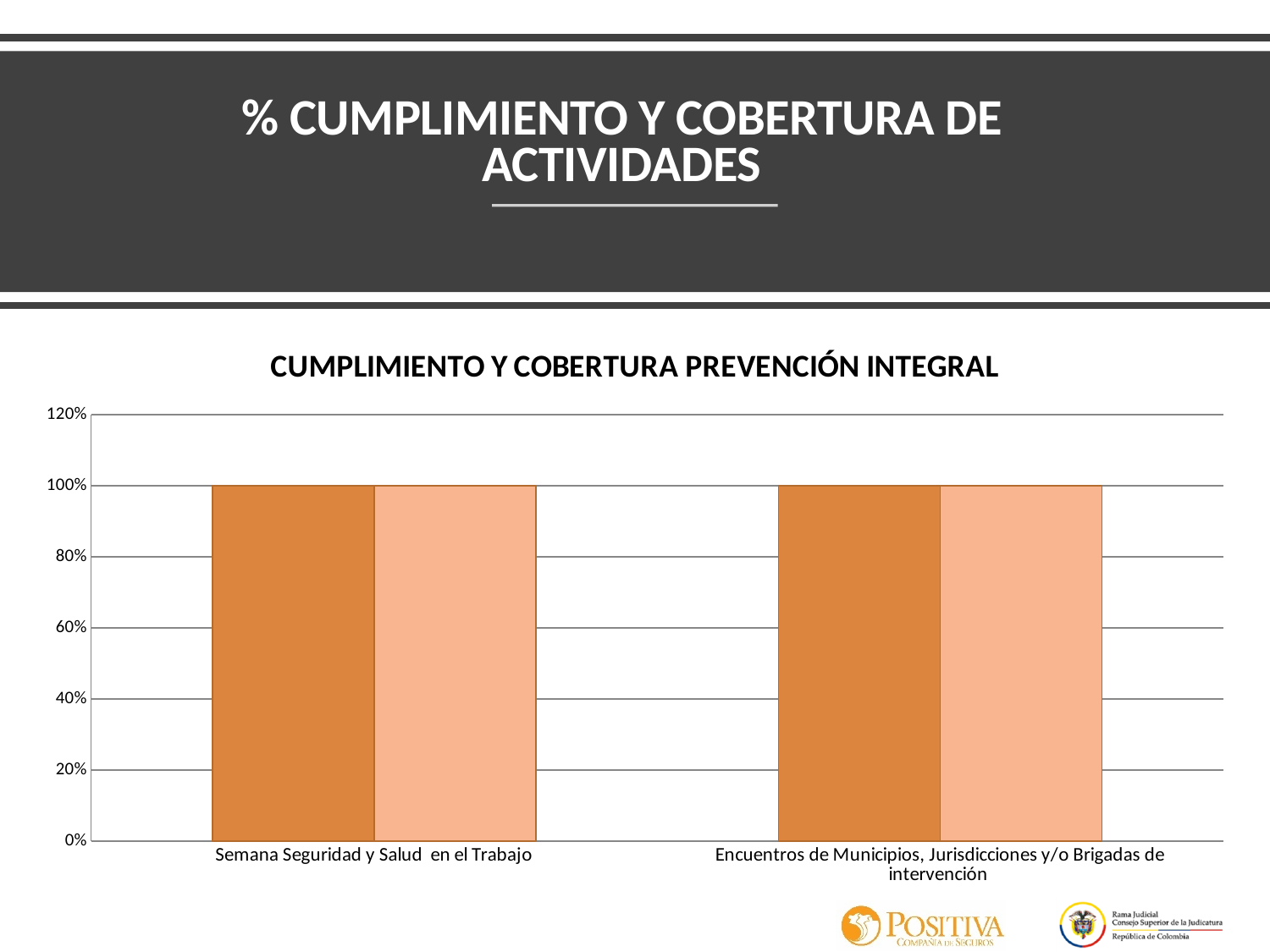
How many bars are plotted in the chart in total? 4 What value do the bars for 'Encuentros de Municipios, Jurisdicciones y/o Brigadas de intervención' reach? 100% Do the values rise, fall, or stay the same from the first category to the second category? stay the same What is the difference between the values for 'Semana Seguridad y Salud en el Trabajo' and 'Encuentros de Municipios, Jurisdicciones y/o Brigadas de intervención'? 0% What kind of chart is shown on the slide? bar chart Is the value for 'Semana Seguridad y Salud en el Trabajo' greater or less than 80%? greater How many categories are shown on the x axis of the chart? 2 What value do the bars for 'Semana Seguridad y Salud en el Trabajo' reach? 100% What is the highest value shown on the vertical axis? 120% Is the value for 'Encuentros de Municipios, Jurisdicciones y/o Brigadas de intervención' greater or less than 120%? less What is the title of the chart? CUMPLIMIENTO Y COBERTURA PREVENCIÓN INTEGRAL